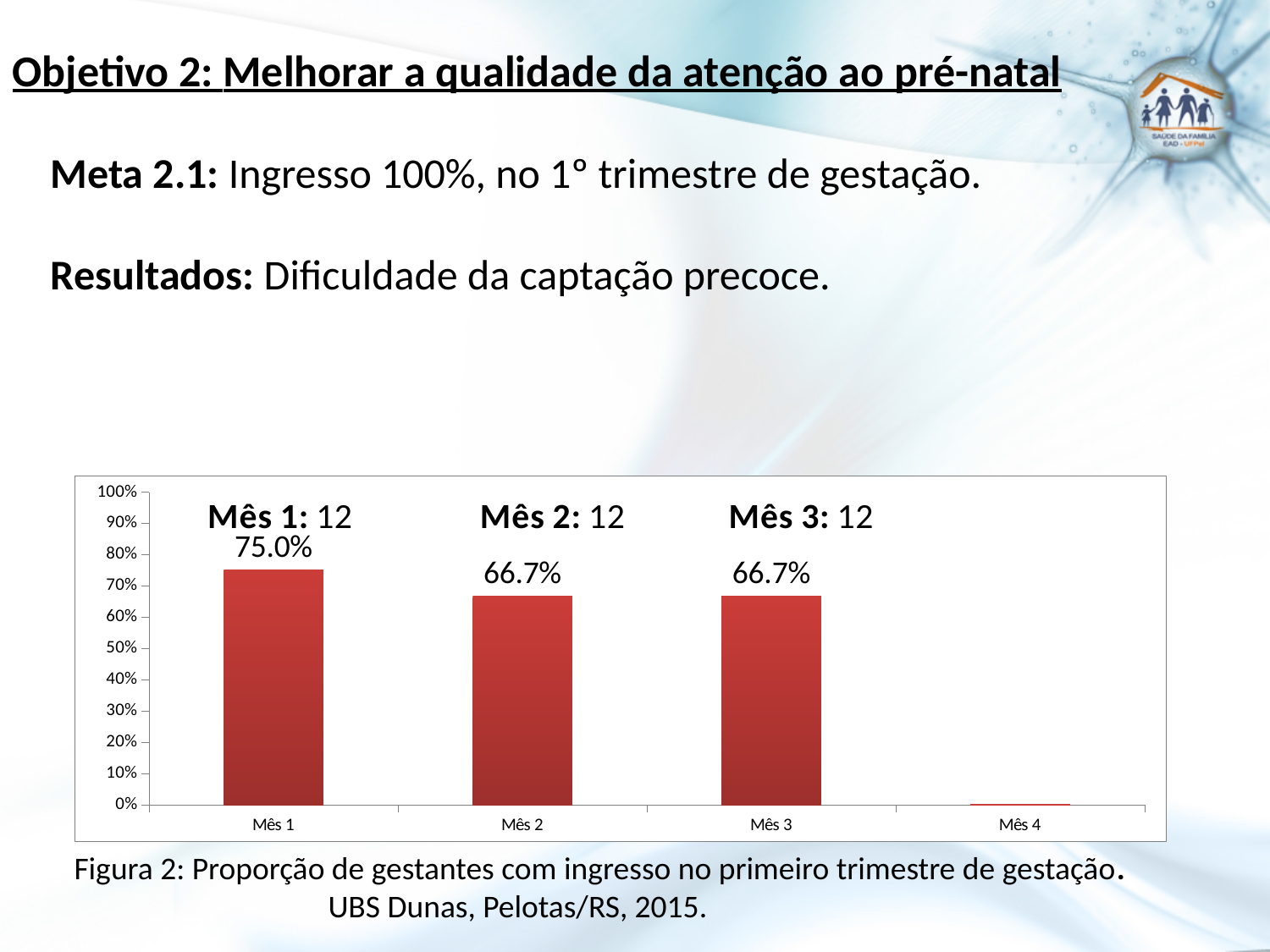
What is the difference between the values for Mês 1 and Mês 2? 8.3 percentage points Is the value for Mês 4 greater or less than 10%? less Do the values rise or fall from Mês 1 to Mês 4? fall What is the value for Mês 3? 66.7% What is the value for Mês 1? 75.0% What kind of chart is shown on the slide? bar chart Which month has the lowest value? Mês 4 How many months are shown on the x axis? 4 What is the value for Mês 2? 66.7% Which is larger, the value for Mês 1 or the value for Mês 3? Mês 1 What is the figure number given in the caption below the chart? Figura 2 Which month has the highest value? Mês 1